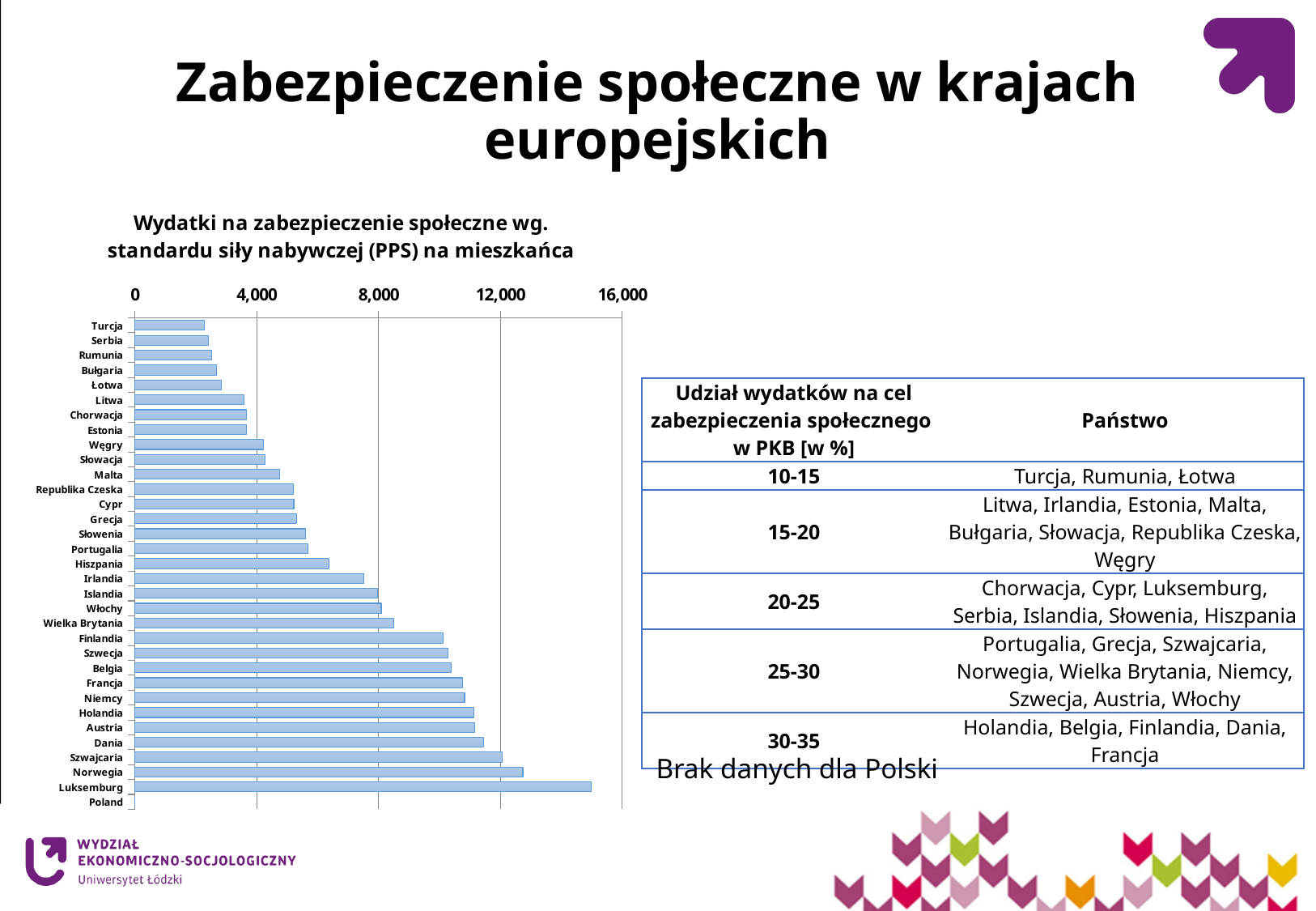
How many countries are listed on the vertical axis of the chart? 33 Is the value for Luksemburg greater or less than 12,000? greater Do the bar values increase or decrease going from the top of the chart (Turcja) down to Luksemburg? increase Which has a larger value, Luksemburg or Norwegia? Luksemburg What is the title of the chart on the slide? Wydatki na zabezpieczenie społeczne wg. standardu siły nabywczej (PPS) na mieszkańca Which country in the chart has no bar plotted at all? Poland Which country has the longest bar in the chart? Luksemburg Which has a larger value, Dania or Malta? Dania Is the value for Finlandia greater or less than 8,000? greater What kind of chart is shown on the slide? bar chart Is the value for Turcja greater or less than 4,000? less